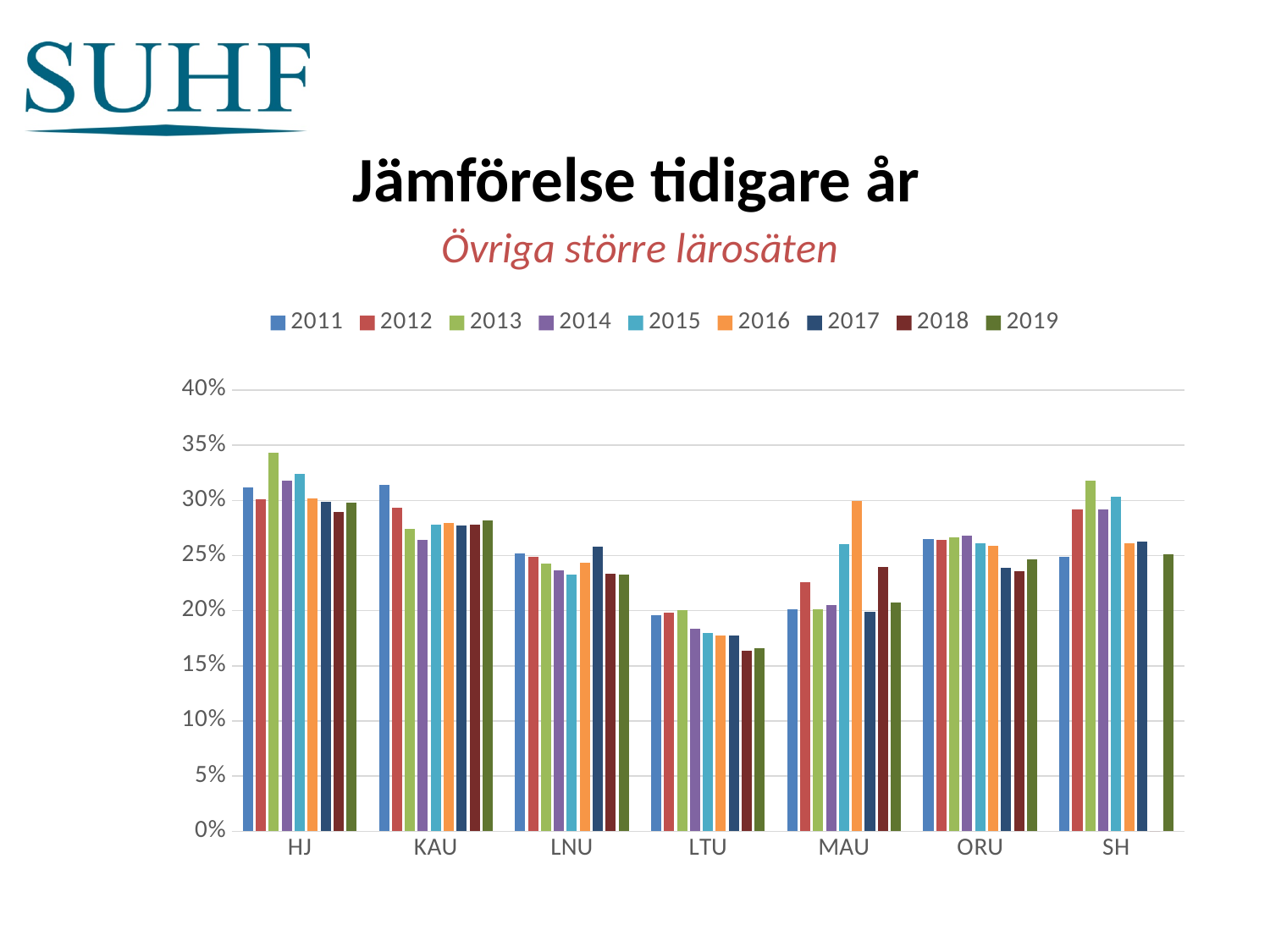
Is the 2013 value for HJ greater or less than 30%? greater How many categories (institutions) are shown on the x axis? 7 Is the 2019 value for LTU greater or less than 20%? less Which year's series has no bar for SH? 2018 Which category has the lowest 2011 value? LTU Do the values for LTU generally rise or fall from 2011 to 2019? fall How many series does the legend list? 9 Is the 2016 value for MAU greater or less than 25%? greater Which category has the highest 2013 value? HJ What kind of chart is shown on the slide? bar chart For MAU, which is larger: the 2016 value or the 2017 value? 2016